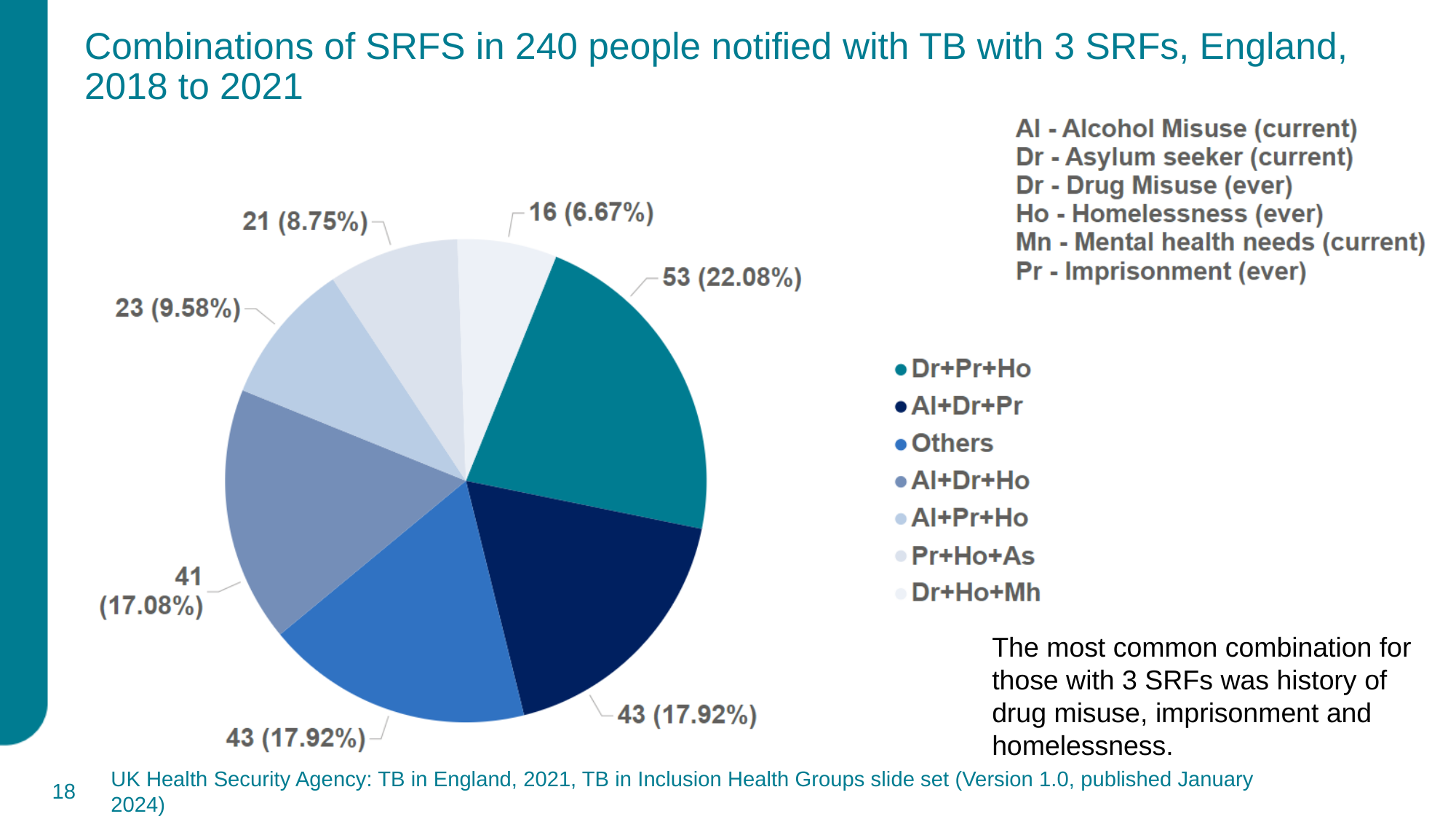
How many slices does the pie chart have? 7 What percentage share does the Dr+Ho+Mh slice represent? 6.67% What is the difference in number of people between the Dr+Pr+Ho slice and the Al+Dr+Pr slice? 10 Which slice is larger, Al+Pr+Ho or Pr+Ho+As? Al+Pr+Ho Which combination has the smallest slice of the pie chart? Dr+Ho+Mh What kind of chart is shown on the slide? Pie chart How many people are in the Al+Dr+Ho slice? 41 Which combination has the largest slice of the pie chart? Dr+Pr+Ho What percentage share does the Al+Pr+Ho slice represent? 9.58% How many people are in the Dr+Pr+Ho slice of the pie chart? 53 What does the abbreviation Ho stand for in the chart's key? Homelessness (ever) What percentage share does the Dr+Pr+Ho slice represent? 22.08%